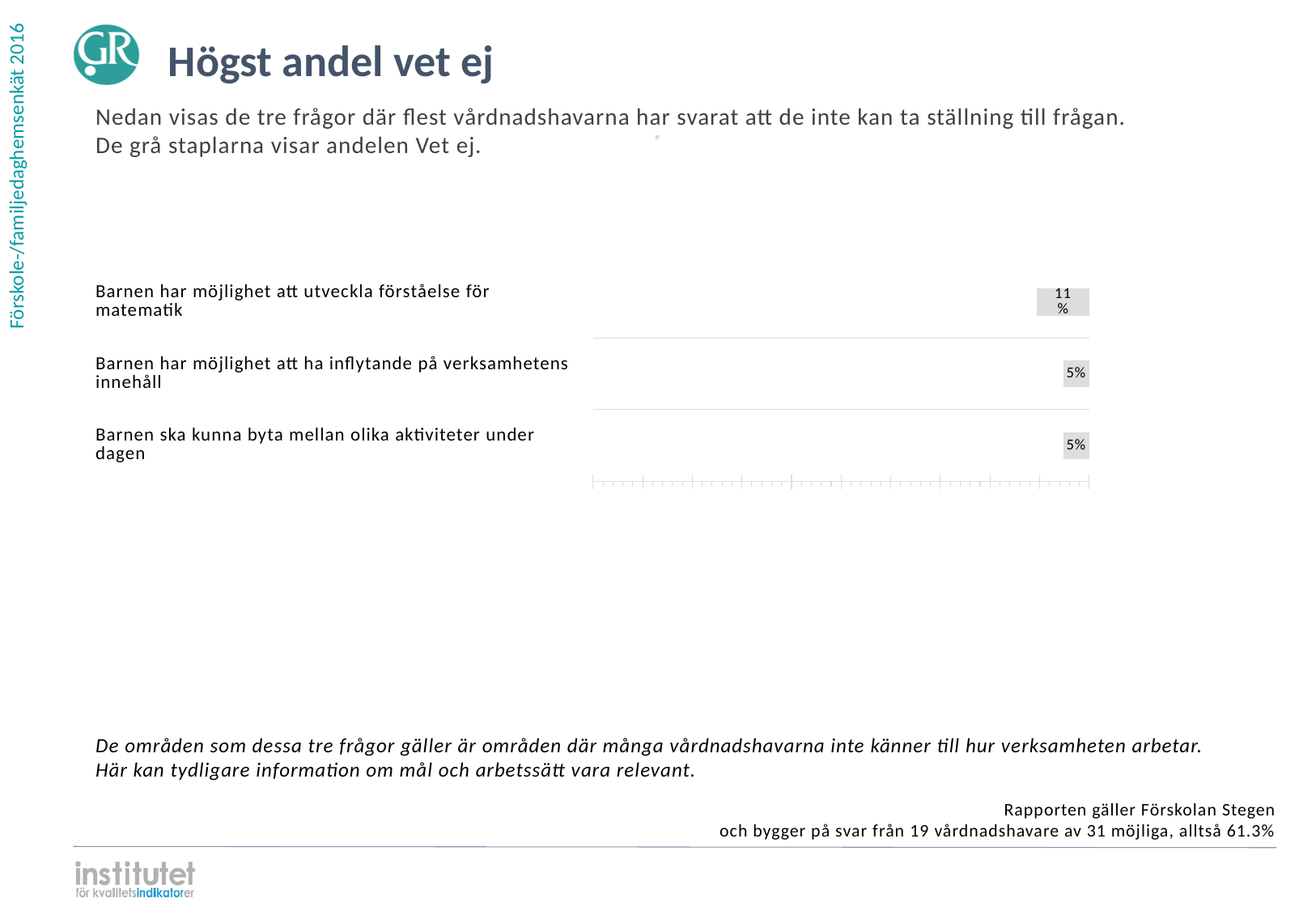
What is the "Vet ej" share for "Barnen har möjlighet att ha inflytande på verksamhetens innehåll"? 5% What is the difference in "Vet ej" share between "Barnen har möjlighet att utveckla förståelse för matematik" and "Barnen ska kunna byta mellan olika aktiviteter under dagen"? 6% What colour are the bars showing the share of "Vet ej"? Grey What percentage of guardians answered "Vet ej" for "Barnen har möjlighet att utveckla förståelse för matematik"? 11% What is the "Vet ej" share for "Barnen ska kunna byta mellan olika aktiviteter under dagen"? 5% What type of chart is shown on the slide? Bar chart What is the title of the slide? Högst andel vet ej How many of the three questions have a "Vet ej" share of 5%? 2 Which has a larger "Vet ej" share: "Barnen har möjlighet att utveckla förståelse för matematik" or "Barnen har möjlighet att ha inflytande på verksamhetens innehåll"? Barnen har möjlighet att utveckla förståelse för matematik How many questions (categories) are shown in the chart? 3 Which question has the highest share of "Vet ej" answers? Barnen har möjlighet att utveckla förståelse för matematik